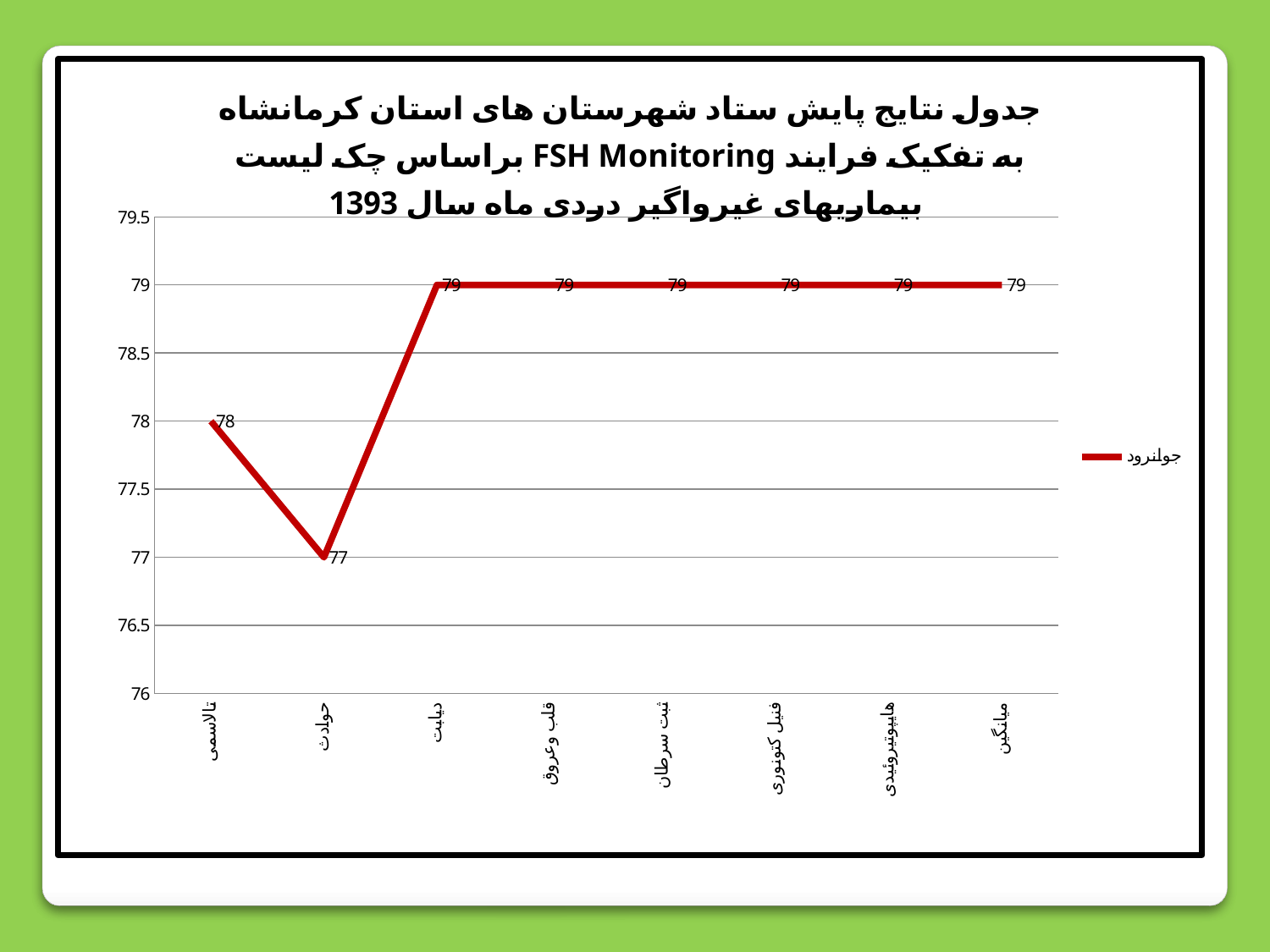
Which category has the lowest value? حوادث What is the difference between the values for تالاسمی and حوادث? 1 What is the value for میانگین? 79 Which is larger, the value for تالاسمی or the value for دیابت? دیابت What is the value for تالاسمی? 78 What is the value for دیابت? 79 Is the value for حوادث greater or less than 77.5? less What series name is shown in the legend? جوانرود How many categories are shown on the x axis? 8 How many series does the legend list? 1 What kind of chart is shown? line chart What is the value for حوادث? 77